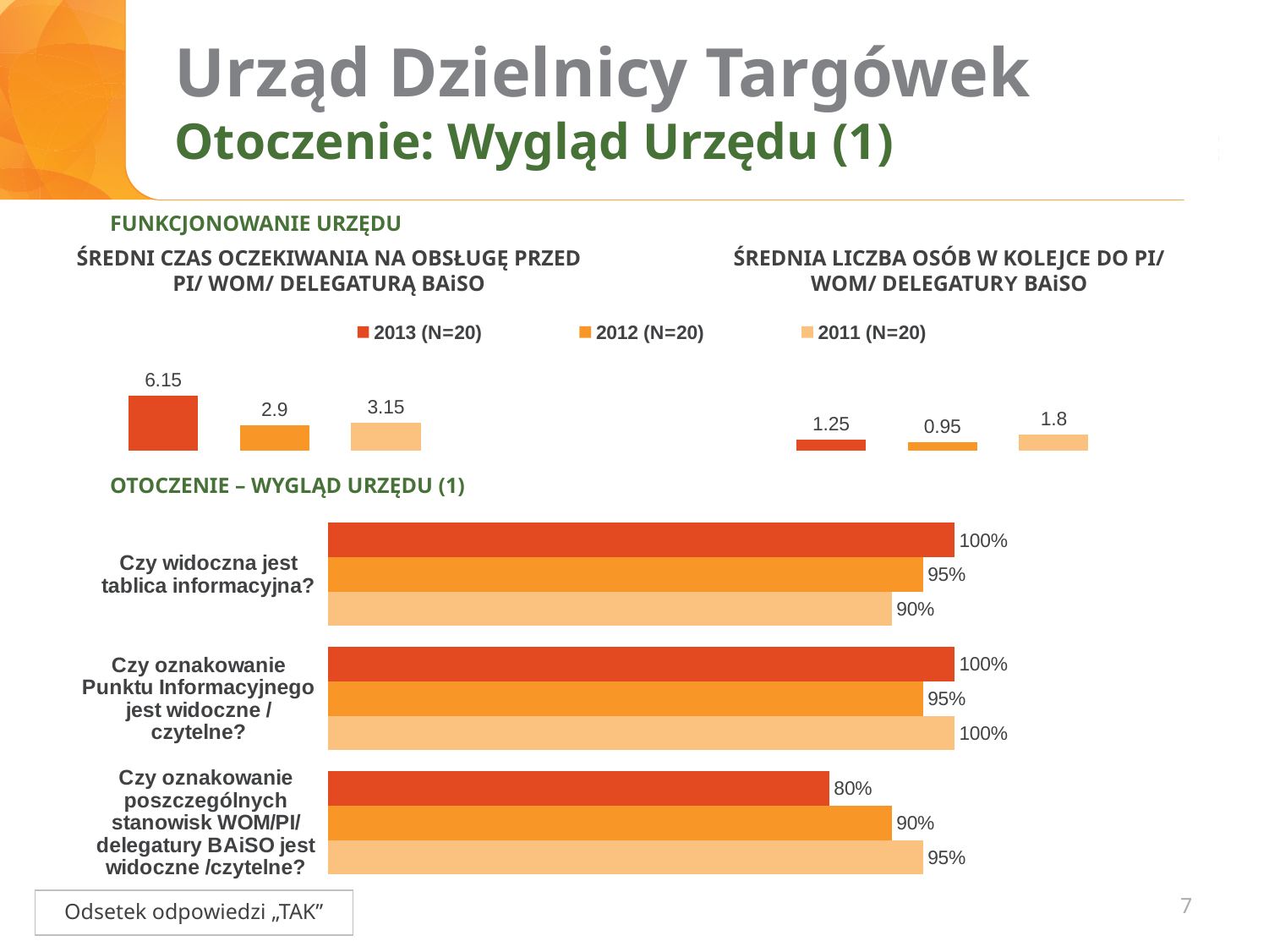
In the chart 'ŚREDNIA LICZBA OSÓB W KOLEJCE DO PI/ WOM/ DELEGATURY BAiSO', which year has the highest value? 2011 (N=20) How many question categories are shown in the bottom chart 'OTOCZENIE – WYGLĄD URZĘDU (1)'? 3 In the chart 'ŚREDNIA LICZBA OSÓB W KOLEJCE DO PI/ WOM/ DELEGATURY BAiSO', is the value for 2013 larger or smaller than the value for 2011? smaller How many series does the legend list for the charts on this slide? 3 In the bottom chart 'OTOCZENIE – WYGLĄD URZĘDU (1)', what is the 2011 value for 'Czy widoczna jest tablica informacyjna?'? 90% In the bottom chart 'OTOCZENIE – WYGLĄD URZĘDU (1)', what is the 2013 value for 'Czy oznakowanie poszczególnych stanowisk WOM/PI/ delegatury BAiSO jest widoczne /czytelne?'? 80% What type of chart is the bottom chart 'OTOCZENIE – WYGLĄD URZĘDU (1)'? bar chart In the bottom chart 'OTOCZENIE – WYGLĄD URZĘDU (1)', what is the difference between the 2011 and 2013 values for 'Czy oznakowanie poszczególnych stanowisk WOM/PI/ delegatury BAiSO jest widoczne /czytelne?'? 15% In the chart 'ŚREDNI CZAS OCZEKIWANIA NA OBSŁUGĘ PRZED PI/ WOM/ DELEGATURĄ BAiSO', which year has the lowest value? 2012 (N=20) In the chart 'ŚREDNI CZAS OCZEKIWANIA NA OBSŁUGĘ PRZED PI/ WOM/ DELEGATURĄ BAiSO', what is the value for 2013 (N=20)? 6.15 In the chart 'ŚREDNIA LICZBA OSÓB W KOLEJCE DO PI/ WOM/ DELEGATURY BAiSO', what is the value for 2012 (N=20)? 0.95 In the chart 'ŚREDNI CZAS OCZEKIWANIA NA OBSŁUGĘ PRZED PI/ WOM/ DELEGATURĄ BAiSO', what is the difference between the 2013 and 2011 values? 3